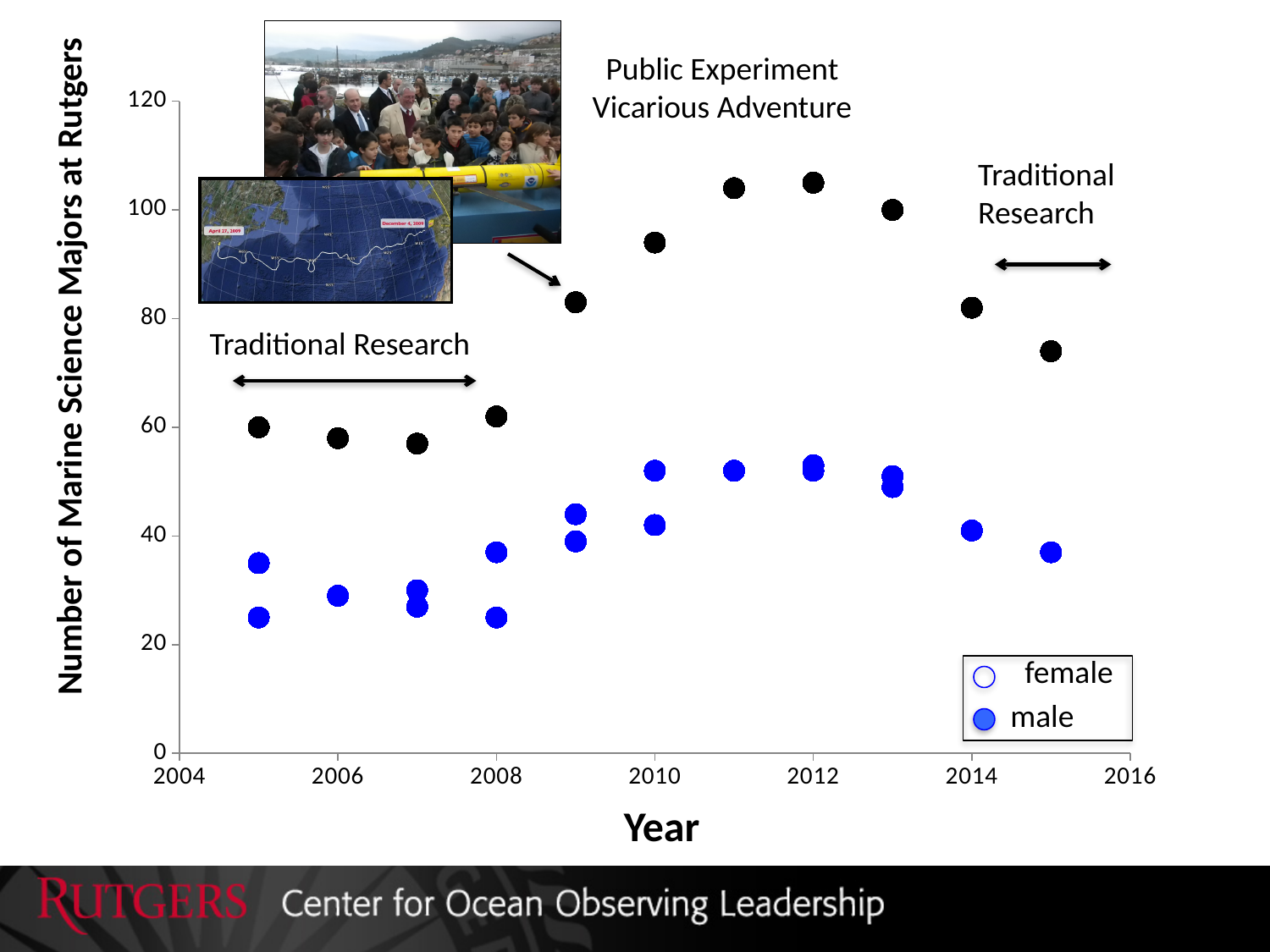
Is the value of the black point for 2015 greater or less than 80? less Is the value of the black point for 2010 greater or less than 100? less Is the higher blue point for 2011 greater or less than 40? greater Which is larger, the black point for 2010 or the black point for 2015? 2010 What is the title of the y axis? Number of Marine Science Majors at Rutgers Do the black points rise or fall from 2008 to 2012? rise What kind of chart is shown on the slide? scatter plot How many series does the legend list? 2 How many years have black data points plotted on the chart? 11 What are the two entries in the chart's legend? female, male